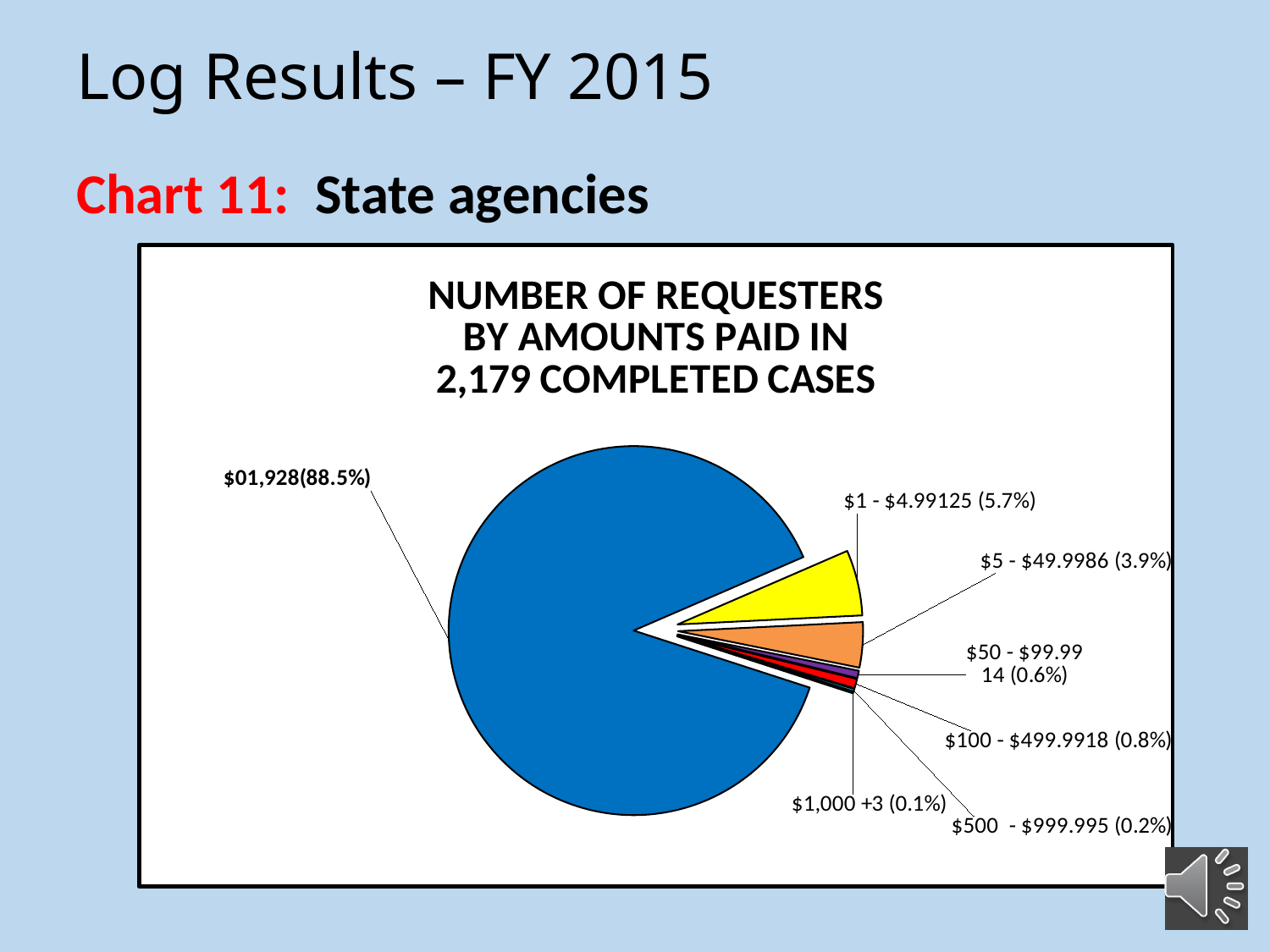
Which category has the smallest share of the pie? $1,000 + What is the title of the chart? NUMBER OF REQUESTERS BY AMOUNTS PAID IN 2,179 COMPLETED CASES What share of the pie is the $1 - $4.99 category? 5.7% Which category has a larger share: $1 - $4.99 or $5 - $49.99? $1 - $4.99 What colour is the largest slice of the pie? blue How many slices does the pie chart have? 7 What share of the pie is the $5 - $49.99 category? 3.9% How many requesters are in the $50 - $99.99 category? 14 What share of the pie is the $0 category? 88.5% Which category has the largest share of the pie? $0 What kind of chart is shown on the slide? pie chart